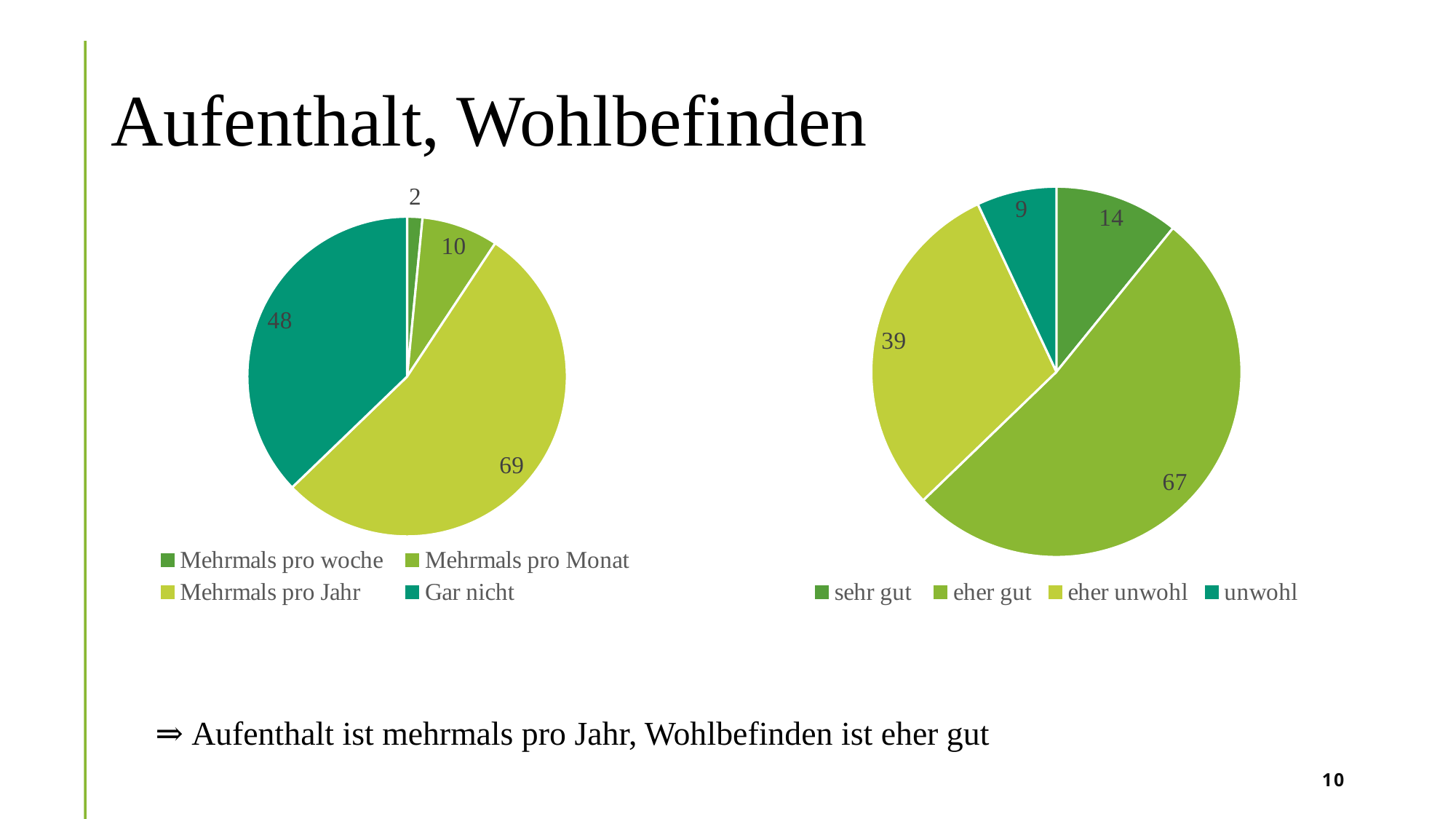
In the left pie chart, what is the difference between Mehrmals pro Jahr and Gar nicht? 21 What type of chart is the left chart on the slide? Pie chart In the left pie chart, what is the value for Mehrmals pro Jahr? 69 In the right pie chart, what is the value for eher unwohl? 39 In the right pie chart, which category has the largest slice? eher gut How many categories does the right pie chart show? 4 In the left pie chart, which category has the smallest slice? Mehrmals pro woche In the left pie chart, what is the value for Gar nicht? 48 In the right pie chart, what is the value for unwohl? 9 In the right pie chart, which category has the smallest slice? unwohl In the right pie chart, which is larger, sehr gut or eher unwohl? eher unwohl In the left pie chart, which category has the largest slice? Mehrmals pro Jahr